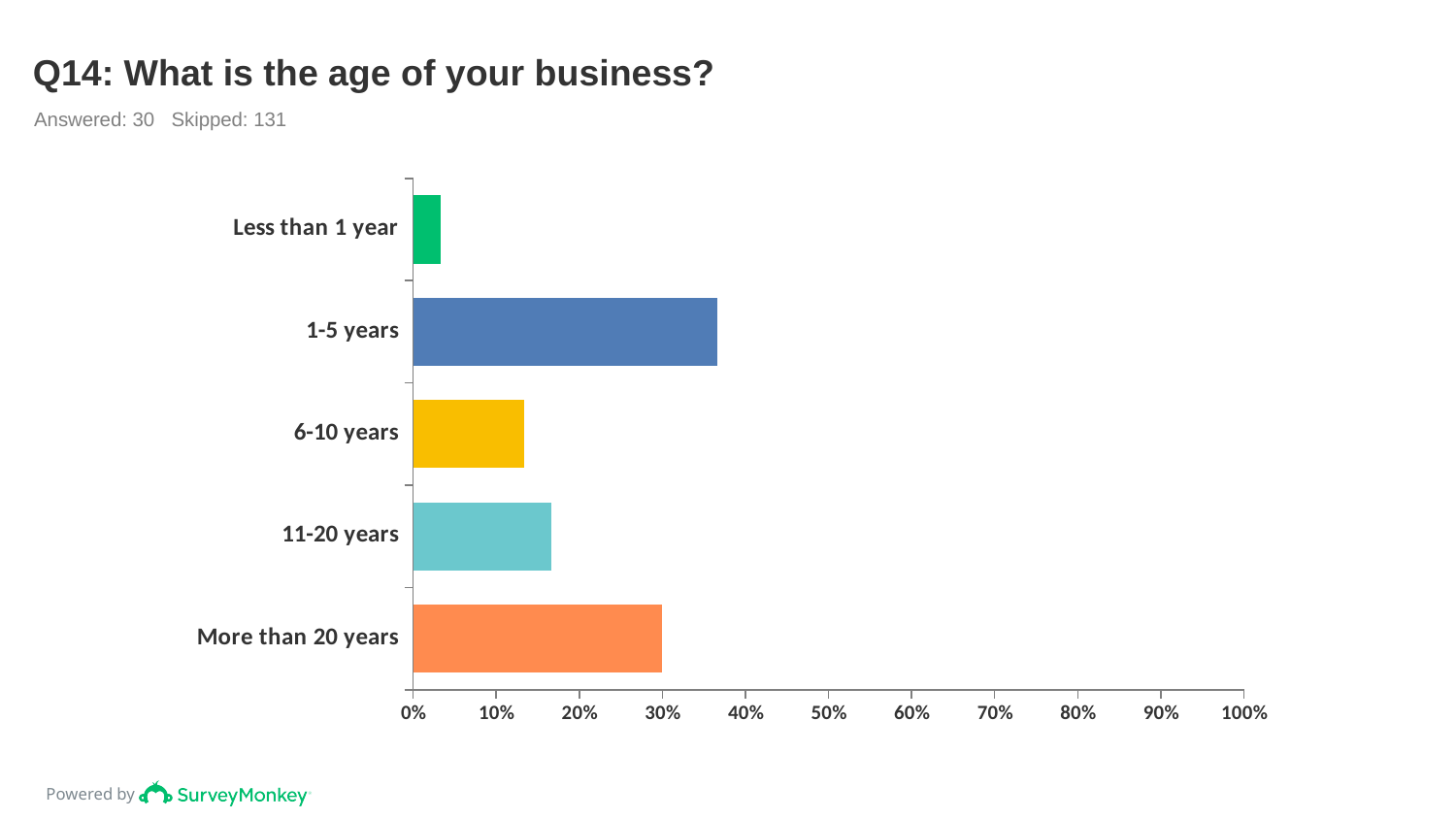
Is the value for Less than 1 year greater or less than 10%? less How many respondents answered this question according to the slide? 30 Is the value for 6-10 years greater or less than 20%? less Is the value for 11-20 years greater or less than 10%? greater Which business age category has the highest percentage? 1-5 years How many categories (age ranges) are shown in the chart? 5 What is the title of the chart? Q14: What is the age of your business? Which business age category has the lowest percentage? Less than 1 year What kind of chart is shown on the slide? bar chart Which is larger, the value for 1-5 years or the value for More than 20 years? 1-5 years Which is larger, the value for Less than 1 year or the value for 6-10 years? 6-10 years